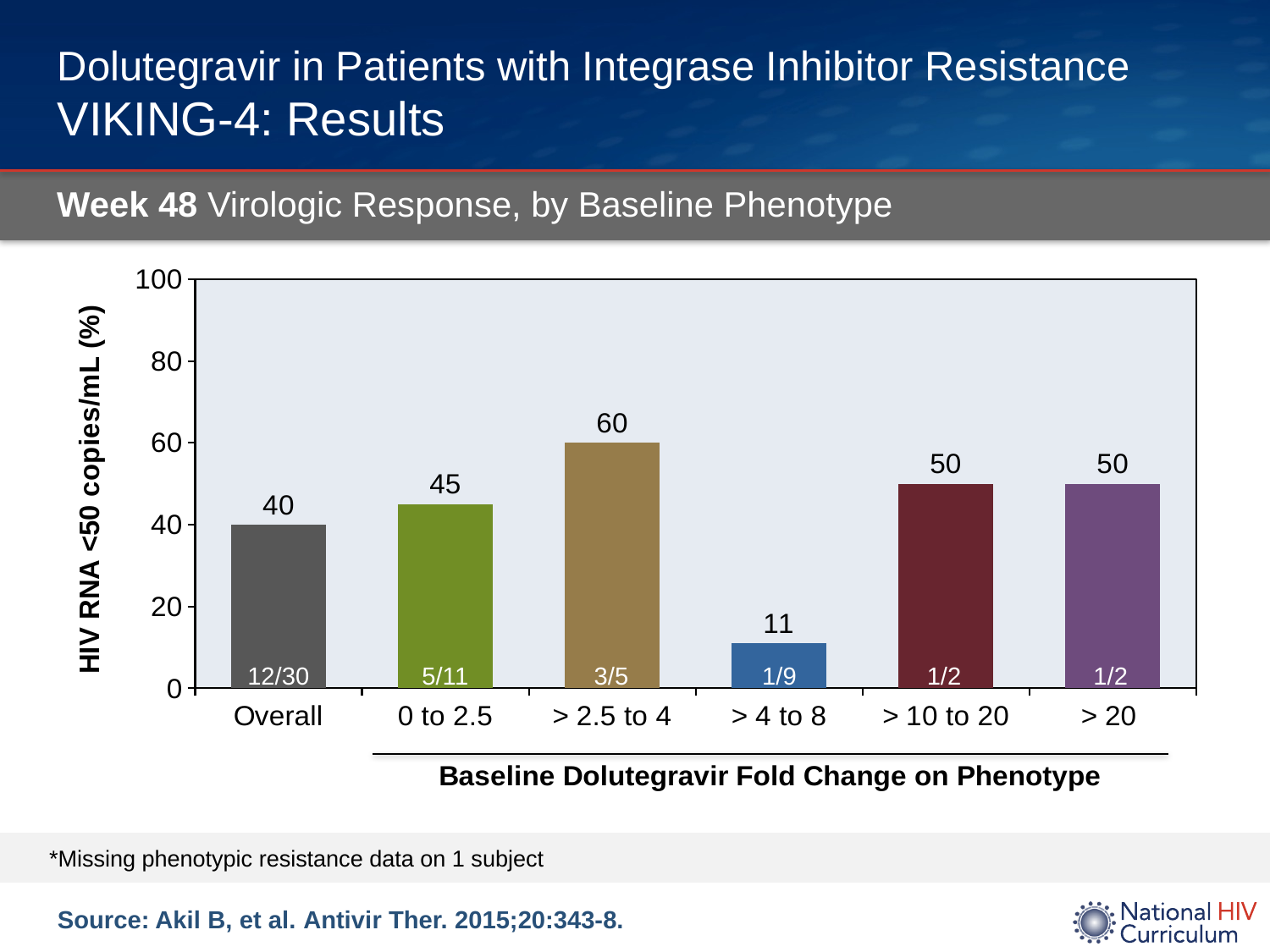
Is the value for > 2.5 to 4 greater or less than 80? less What is the value for the Overall category? 40 What is the y-axis label of the chart? HIV RNA <50 copies/mL (%) Which category has the highest value? > 2.5 to 4 What is the value for the > 4 to 8 category? 11 What is the difference between the values for > 2.5 to 4 and Overall? 20 Which category has the lowest value? > 4 to 8 How many categories are shown on the x axis? 6 What fraction of subjects is shown inside the bar for the 0 to 2.5 category? 5/11 What kind of chart is shown on the slide? bar chart What is the label under the bracket spanning the phenotype categories on the x axis? Baseline Dolutegravir Fold Change on Phenotype Which is larger, the value for 0 to 2.5 or the value for > 10 to 20? > 10 to 20